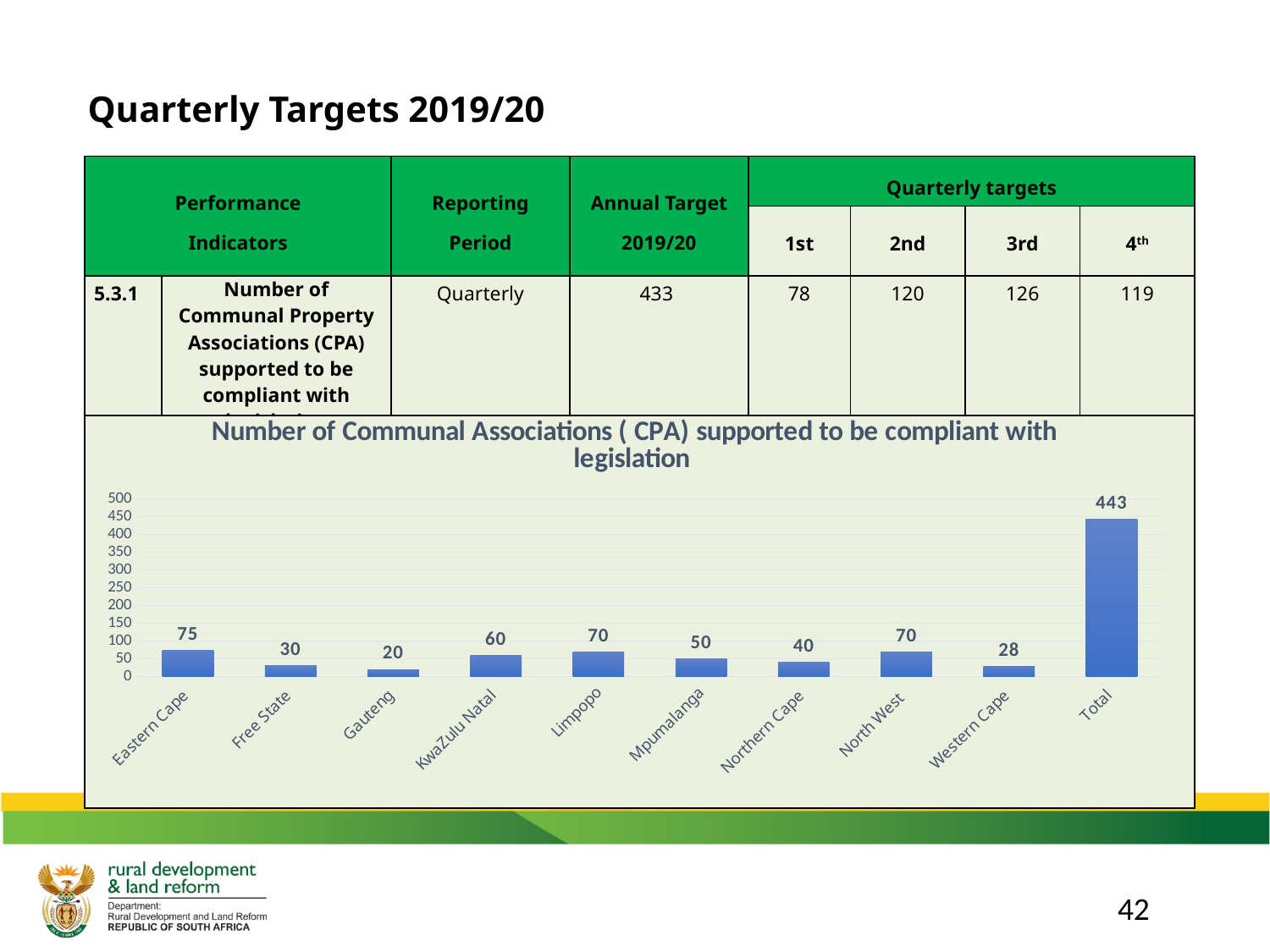
Which is larger, the value for Mpumalanga or the value for Northern Cape? Mpumalanga What is the title of the chart? Number of Communal Associations ( CPA) supported to be compliant with legislation Is the value for Total greater or less than 400? greater Which province has the lowest value in the chart? Gauteng What is the value shown for Total in the chart? 443 How many bars are plotted in the chart, including the Total bar? 10 What is the difference between the values for Limpopo and North West? 0 What is the value for Western Cape in the chart? 28 What is the value for Eastern Cape in the chart? 75 What kind of chart is shown on the slide? bar chart What is the difference between the values for KwaZulu Natal and Free State? 30 Excluding the Total bar, which province has the highest value in the chart? Eastern Cape